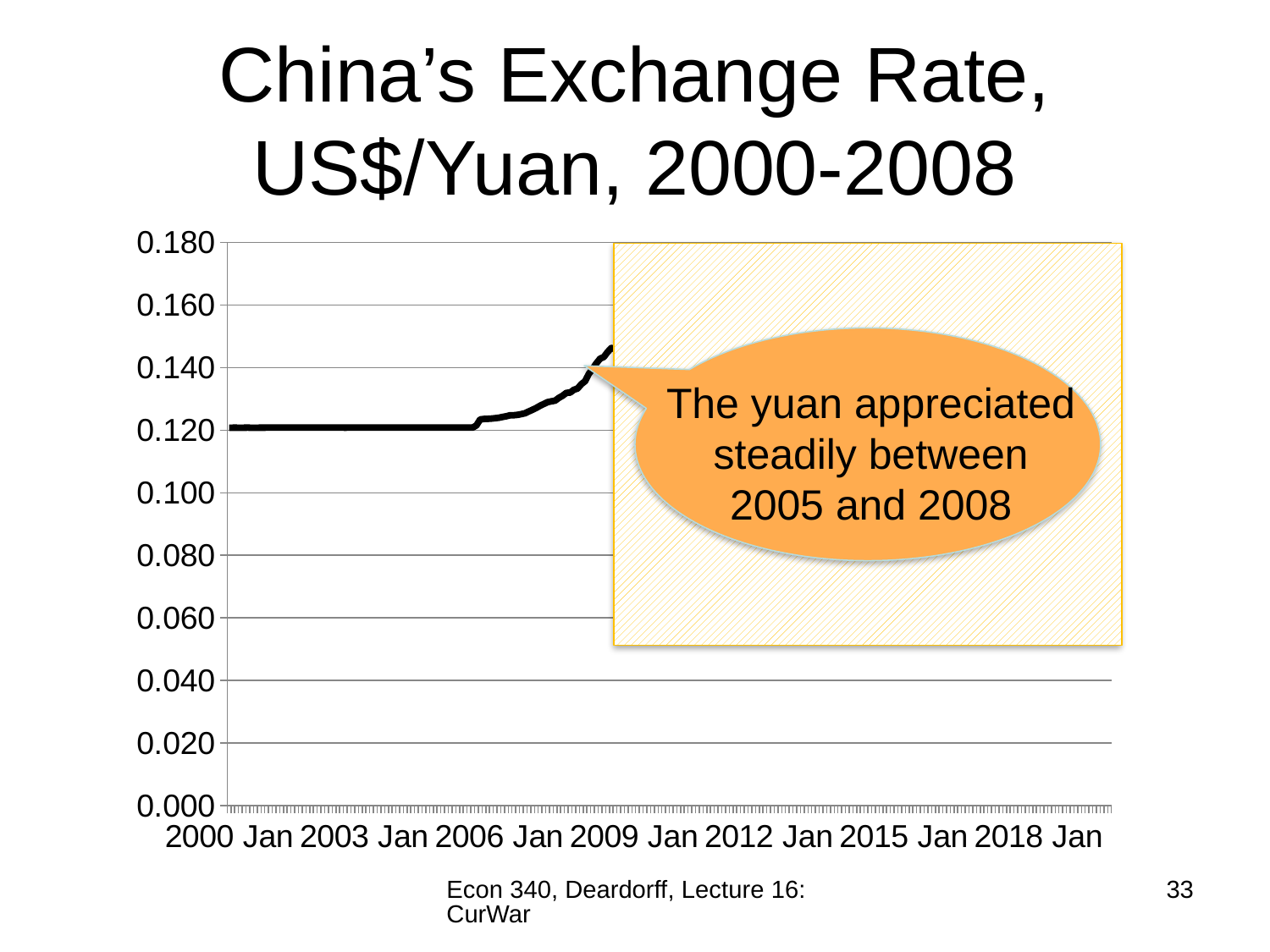
Does the exchange rate rise or fall between 2005 and 2008? rise What is the title of the chart? China's Exchange Rate, US$/Yuan, 2000-2008 What kind of chart is shown on the slide? line chart Which is larger, the exchange rate in 2003 Jan or the exchange rate in 2008? 2008 Is the exchange rate at the end of the plotted line (2008) greater or less than 0.160? less Between 2000 and 2005, does the exchange rate rise, fall, or stay flat? stay flat Is the exchange rate in 2003 Jan greater or less than 0.100? greater Is the exchange rate in 2003 Jan greater or less than 0.140? less What is the highest value labelled on the y axis? 0.180 How many year labels are shown on the x axis? 7